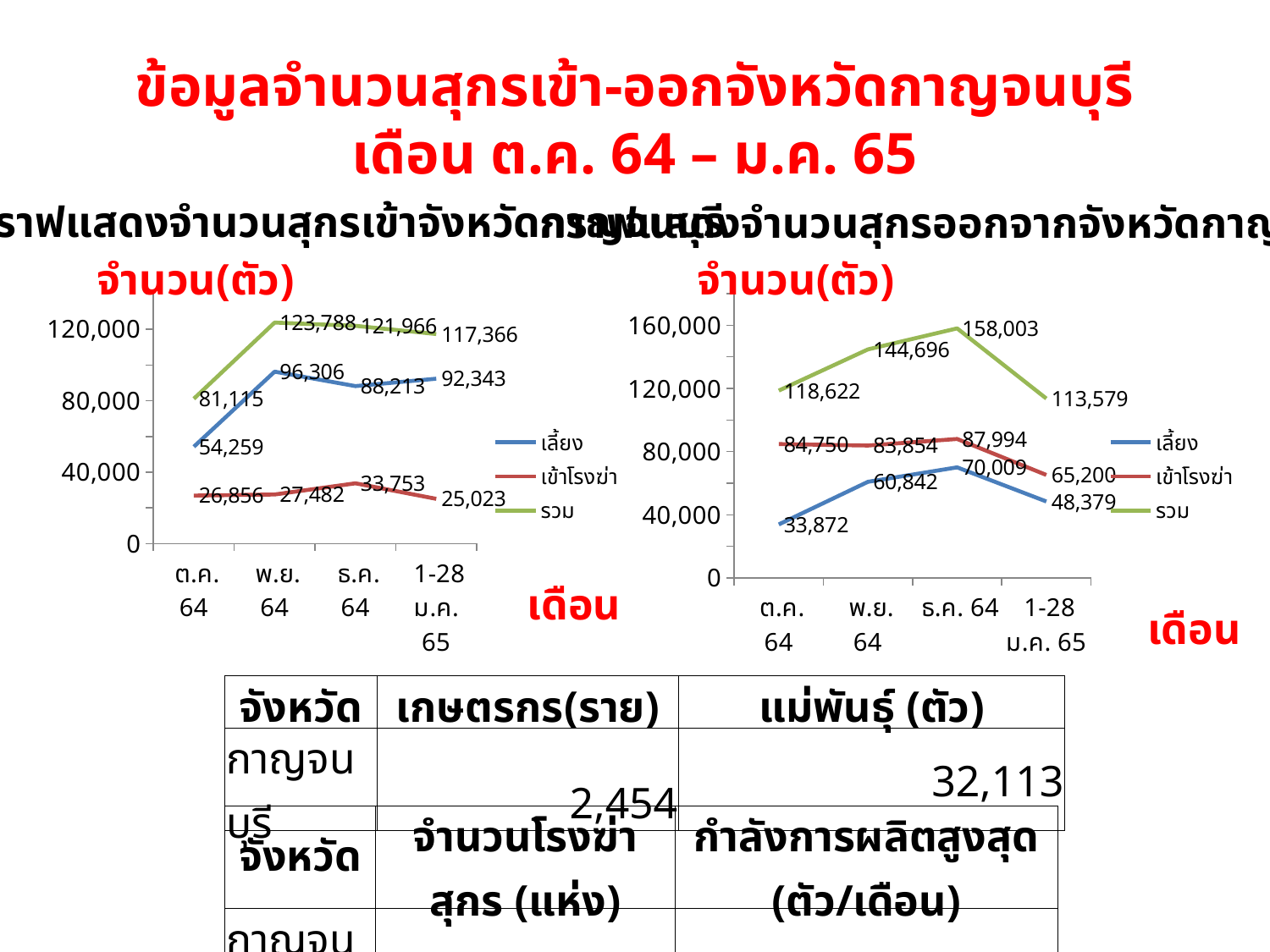
In the right chart, in which month does the รวม series reach its highest value? ธ.ค. 64 In the right chart, does the เข้าโรงฆ่า series rise or fall from ธ.ค. 64 to 1-28 ม.ค. 65? Fall In the left chart, in which month is the เลี้ยง series lowest? ต.ค. 64 In the right chart, what is the value of the รวม series for 1-28 ม.ค. 65? 113,579 In the right chart, which is larger for ต.ค. 64: the เลี้ยง value or the เข้าโรงฆ่า value? เข้าโรงฆ่า In the right chart, what is the value of the เลี้ยง series for ธ.ค. 64? 70,009 How many months are shown on the x axis of the left chart? 4 In the left chart, what is the value of the รวม series for พ.ย. 64? 123,788 In the left chart, what is the difference between the เลี้ยง values for พ.ย. 64 and ต.ค. 64? 42,047 What type of chart is the left chart? Line chart How many series does the legend of the right chart list? 3 In the left chart, what is the value of the เข้าโรงฆ่า series for ธ.ค. 64? 33,753